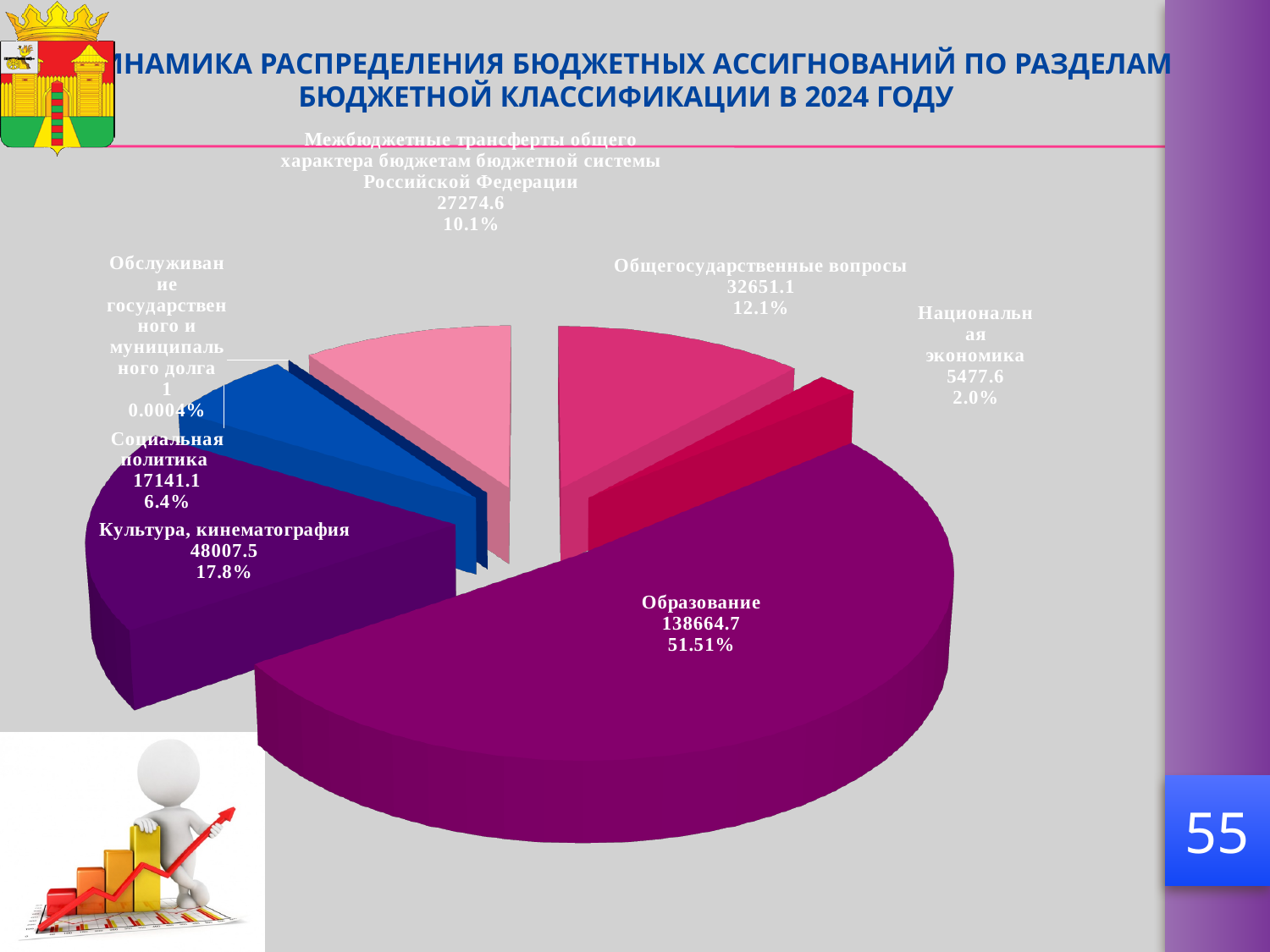
What is the value shown for Культура, кинематография? 48007.5 How many categories (slices) does the pie chart show? 7 What share of the pie does Образование represent? 51.51% What is the value shown for Образование? 138664.7 What is the value shown for Общегосударственные вопросы? 32651.1 What percentage is shown for Социальная политика? 6.4% What kind of chart is shown on the slide? Pie chart Which category has the largest slice of the pie? Образование Which category has the smallest slice of the pie? Обслуживание государственного и муниципального долга Which is larger: the value for Общегосударственные вопросы or the value for Межбюджетные трансферты общего характера бюджетам бюджетной системы Российской Федерации? Общегосударственные вопросы What is the difference between the values for Культура, кинематография and Социальная политика? 30866.4 What percentage is shown for Национальная экономика? 2.0%